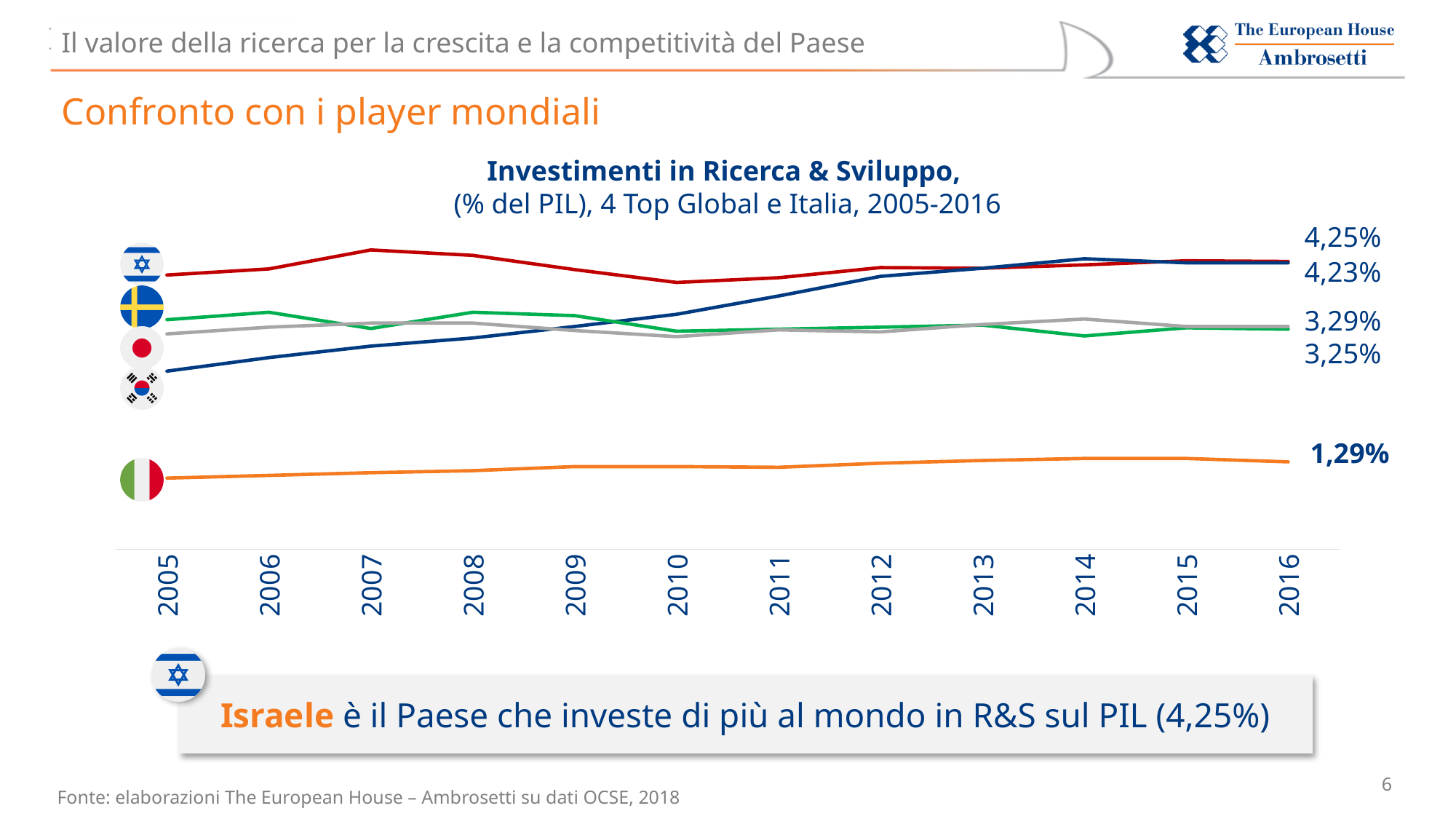
What is the title of the chart? Investimenti in Ricerca & Sviluppo, (% del PIL), 4 Top Global e Italia, 2005-2016 Does the dark blue line (South Korea) rise or fall from 2005 to 2016? rises What is the R&D investment value for Israel in 2016? 4,25% How many years are shown on the x axis of the chart? 12 What is the difference between Israel's 2016 value (4,25%) and Italy's 2016 value (1,29%)? 2,96 percentage points What is the difference between the two highest 2016 values shown, 4,25% and 4,23%? 0,02 percentage points Which country has the lowest R&D investment as % of GDP in 2016? Italy What kind of chart is shown on the slide? line chart Which is larger in 2016: Israel's value or Italy's value? Israel's value How many country lines are plotted in the chart? 5 What is the R&D investment value for Italy (orange line) in 2016? 1,29% Which country has the highest R&D investment as % of GDP in 2016? Israel